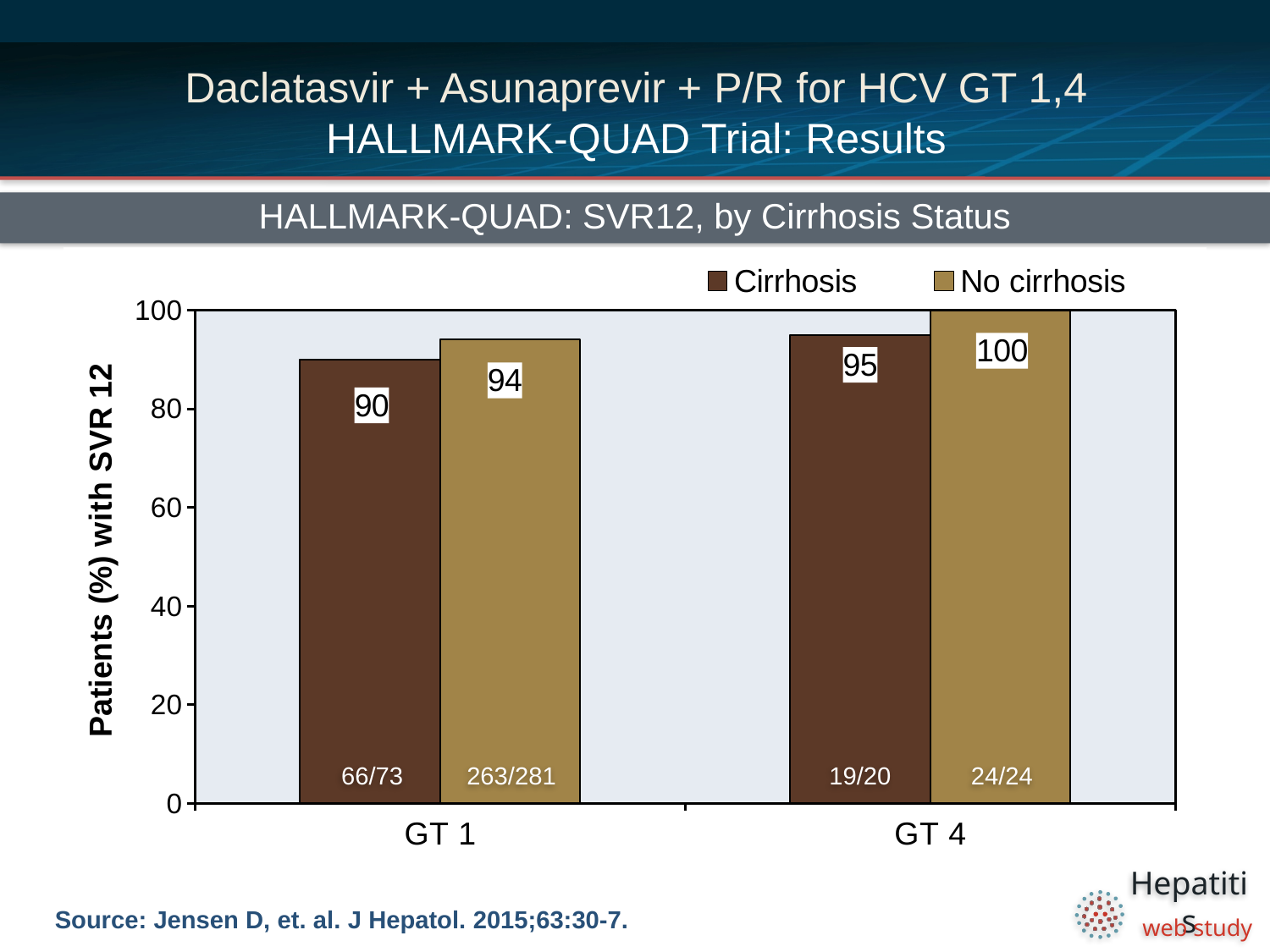
Which bar shows the lowest SVR12 rate? Cirrhosis, GT 1 What fraction of patients is printed on the no cirrhosis bar for GT 1? 263/281 What is the SVR12 rate for patients with cirrhosis in the GT 1 group? 90 What is the SVR12 rate for patients with no cirrhosis in the GT 4 group? 100 Which bar shows the highest SVR12 rate? No cirrhosis, GT 4 How many genotype categories are shown on the x axis? 2 Which is larger for GT 4: the SVR12 rate for cirrhosis or for no cirrhosis? No cirrhosis What kind of chart is shown on the slide? Bar chart How many series does the legend list? 2 What is the difference in SVR12 rate between the no cirrhosis and cirrhosis groups for GT 1? 4 What is the SVR12 rate for patients with cirrhosis in the GT 4 group? 95 What is the SVR12 rate for patients with no cirrhosis in the GT 1 group? 94